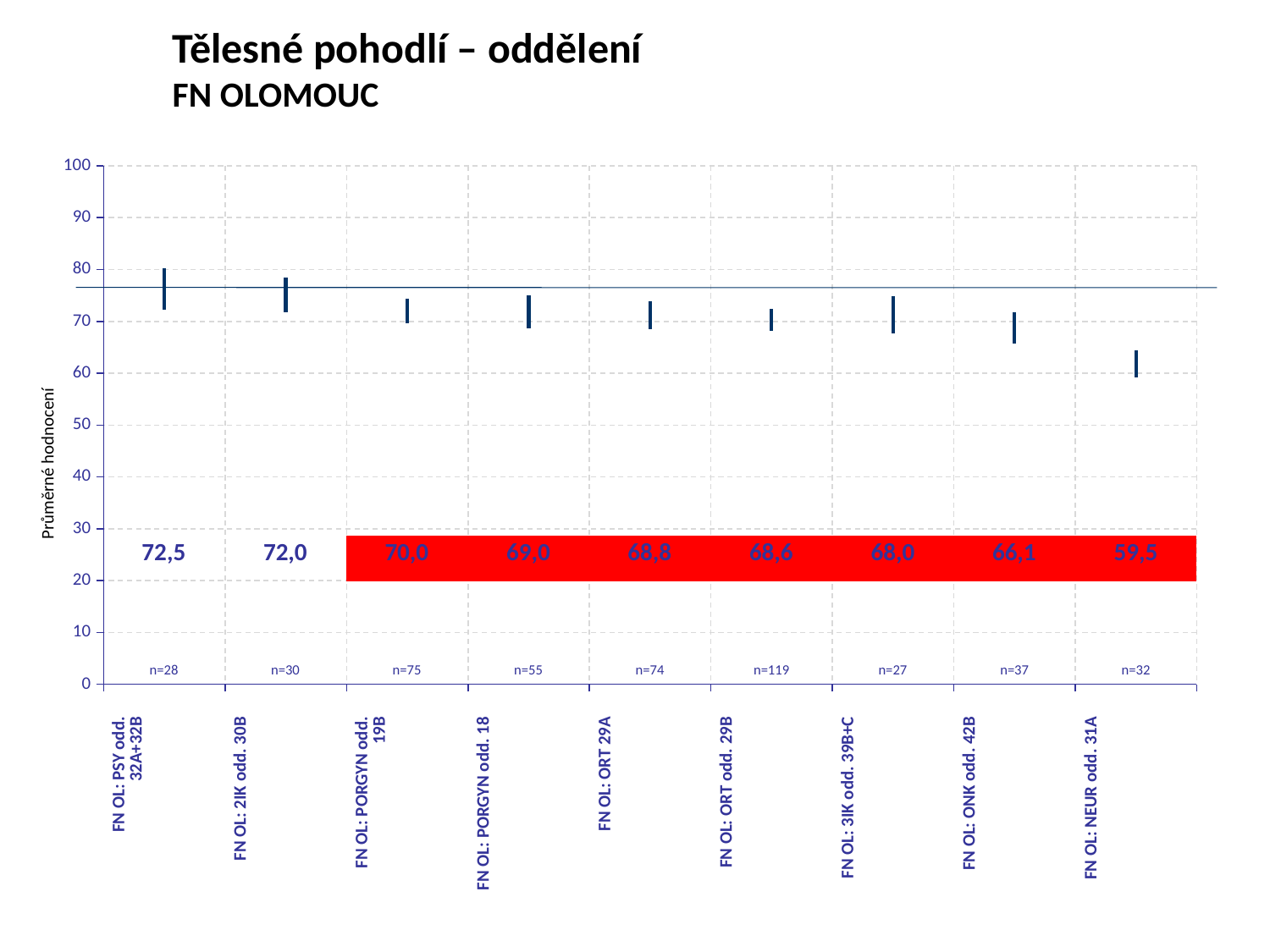
Which department has the highest value? FN OL: PSY odd. 32A+32B What is the value for FN OL: PSY odd. 32A+32B? 72,5 Which is larger, the value for FN OL: 2IK odd. 30B or FN OL: ONK odd. 42B? FN OL: 2IK odd. 30B What is the value for FN OL: ORT odd. 29B? 68,6 Do the values rise or fall from left to right along the x axis? fall What is the difference between the values for FN OL: PSY odd. 32A+32B and FN OL: NEUR odd. 31A? 13,0 What is the value for FN OL: NEUR odd. 31A? 59,5 What is the title of the chart? Tělesné pohodlí – oddělení FN OLOMOUC What is the label of the y axis? Průměrné hodnocení What is the sample size (n) shown for FN OL: ORT odd. 29B? n=119 Which department has the lowest value? FN OL: NEUR odd. 31A How many departments are shown on the chart? 9